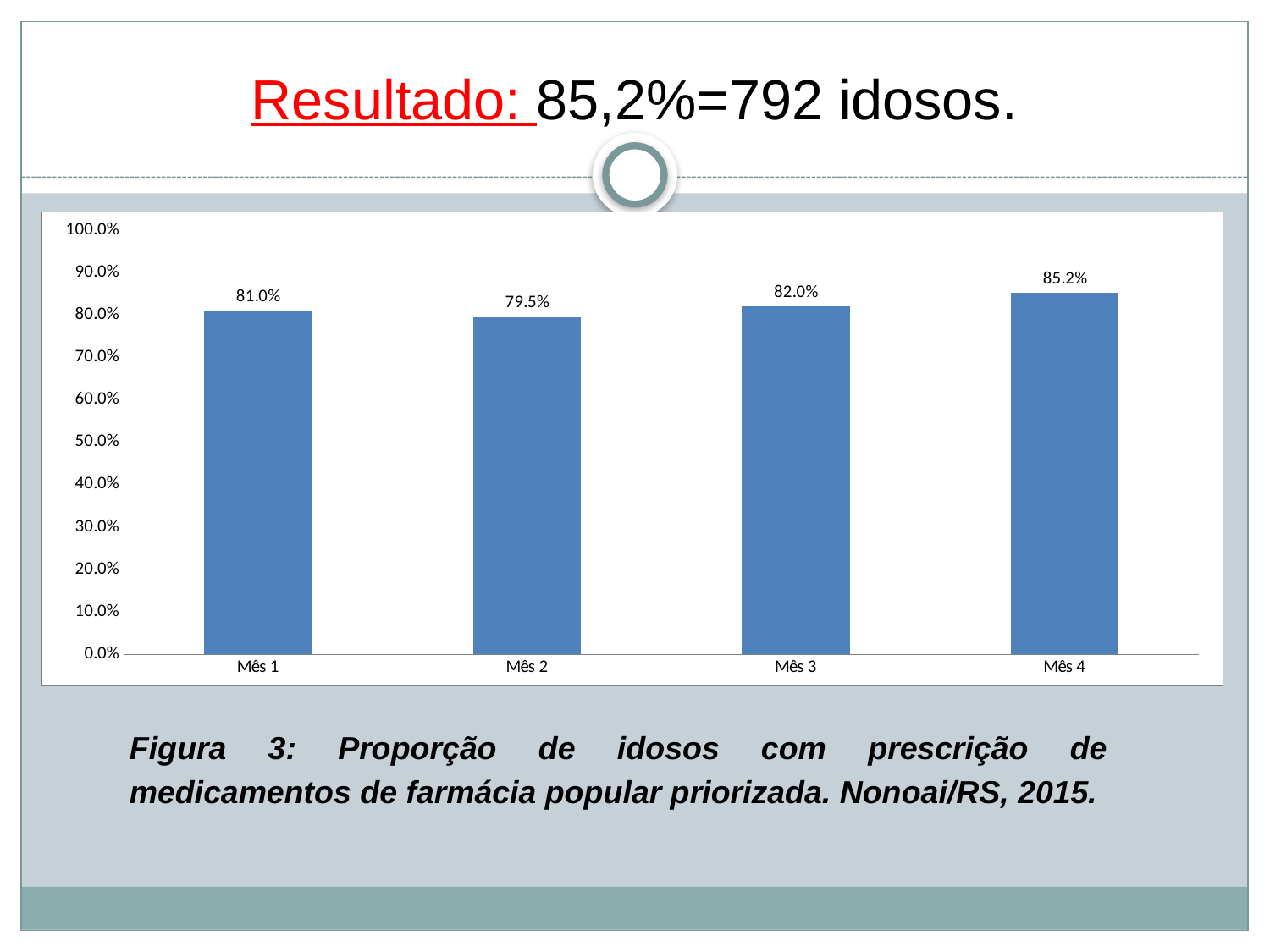
What is the value for Mês 3? 82.0% What is the value for Mês 2? 79.5% How many months are shown on the x axis? 4 What is the value for Mês 4? 85.2% What is the difference between the values for Mês 4 and Mês 1? 4.2% Which is larger, the value for Mês 3 or the value for Mês 2? Mês 3 What kind of chart is shown on the slide? bar chart Which month has the lowest value? Mês 2 Do the values rise or fall from Mês 2 to Mês 4? rise What is the value for Mês 1? 81.0% Which month has the highest value? Mês 4 Is the value for Mês 4 greater or less than 80.0%? greater